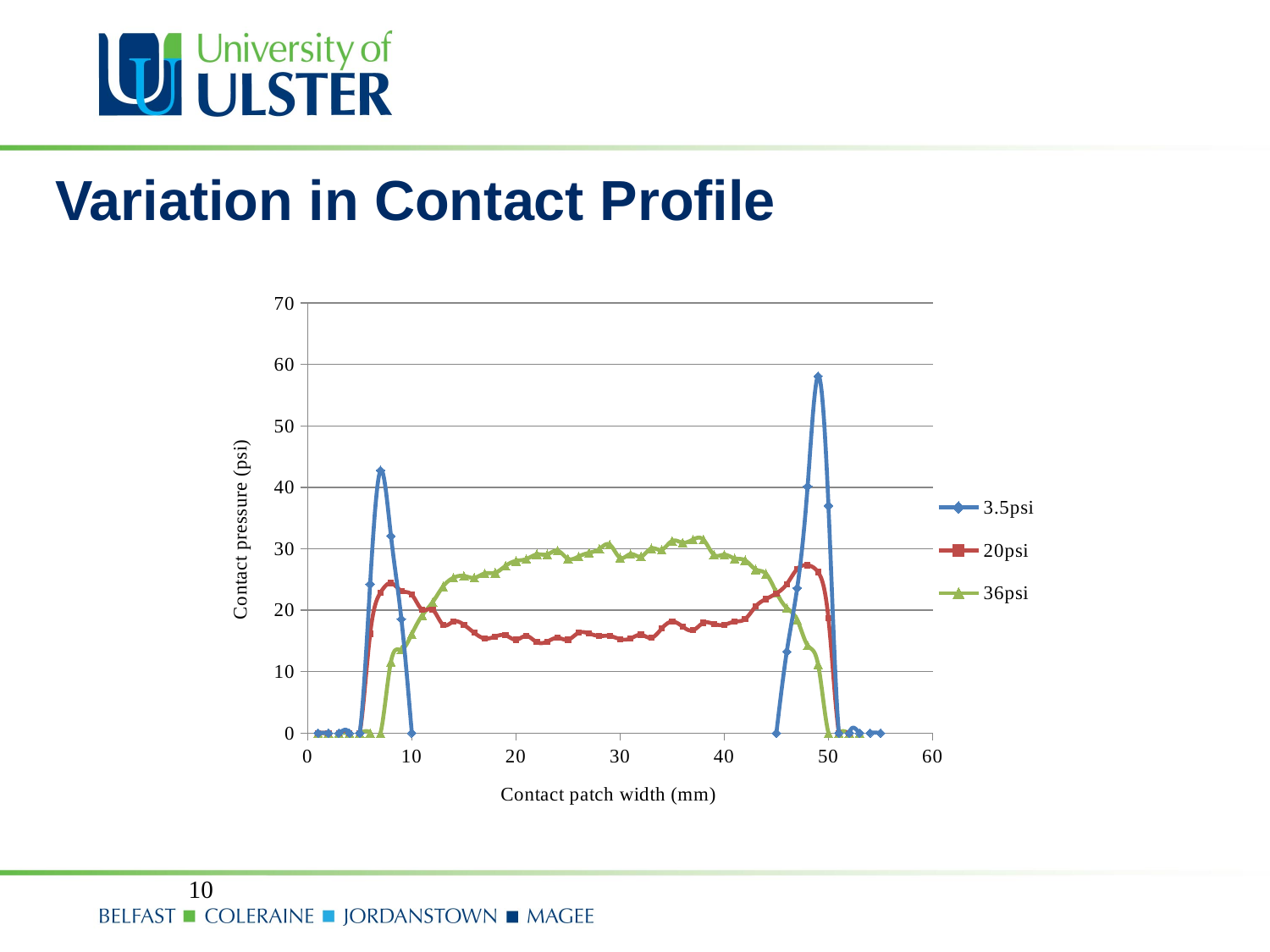
How many series does the legend list? 3 Is the value of the 20psi series at a contact patch width of 30 mm greater or less than 20? less Between contact patch widths of 10 mm and 30 mm, does the 36psi series rise or fall? rise Is the value of the 36psi series at a contact patch width of 20 mm greater or less than 20? greater Which series reaches the highest contact pressure anywhere on the chart? 3.5psi Which series has the lowest peak contact pressure? 20psi What is the label of the vertical axis? Contact pressure (psi) Is the peak value of the 3.5psi series near a contact patch width of 49 mm greater or less than 50? greater What are the three series named in the legend? 3.5psi, 20psi, 36psi What kind of chart is shown on the slide? line chart At a contact patch width of 30 mm, which series has the larger value, 20psi or 36psi? 36psi